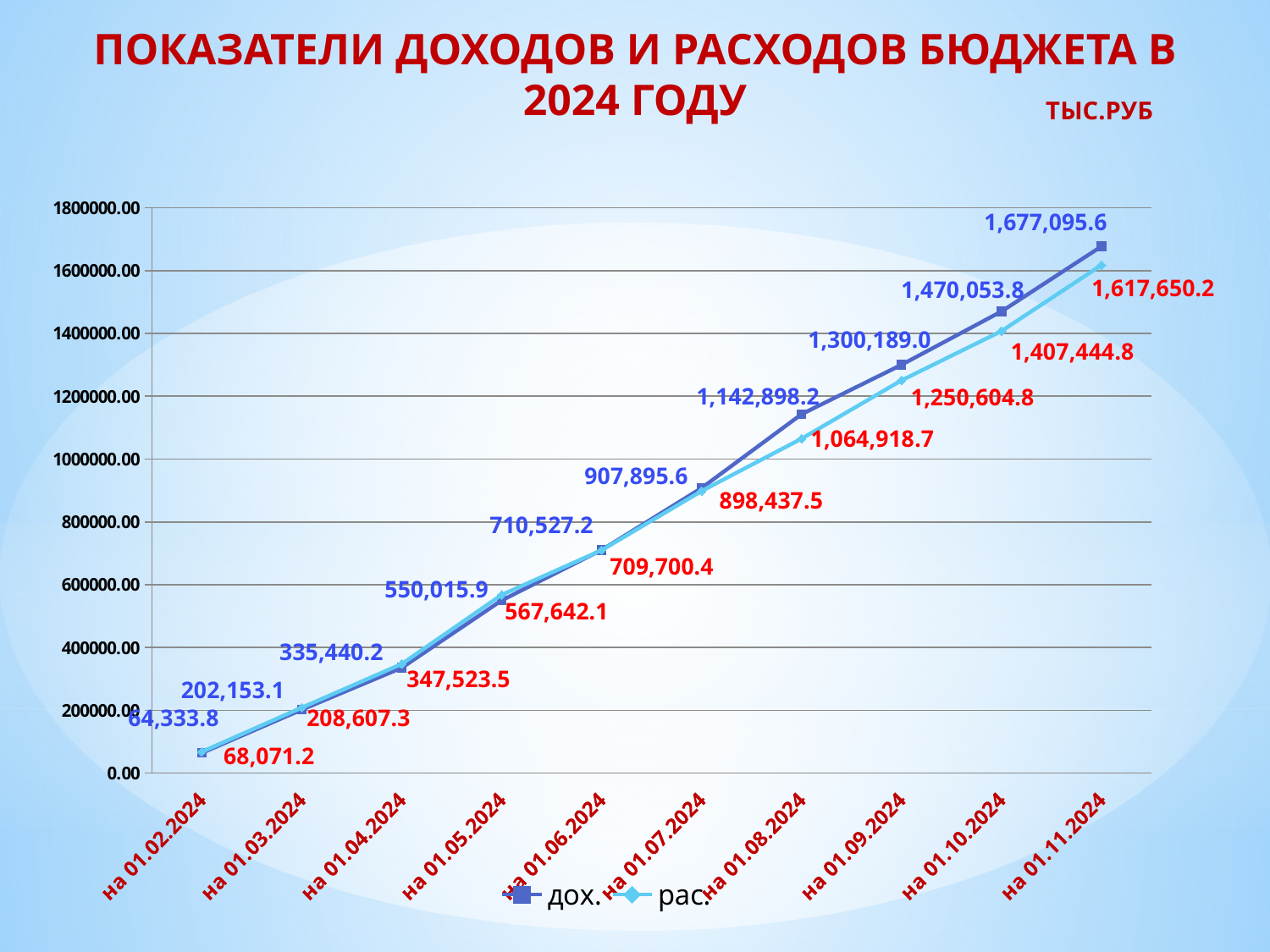
What is the difference between дох. and рас. on на 01.11.2024? 59,445.4 On which date is the рас. series at its lowest value? на 01.02.2024 How many series does the legend list? 2 What is the value of рас. on на 01.09.2024? 1,250,604.8 What kind of chart is shown on the slide? line chart What is the value of дох. on на 01.04.2024? 335,440.2 What is the value of дох. on на 01.07.2024? 907,895.6 How many dates are plotted on the x axis? 10 Which series has the larger value on на 01.10.2024, дох. or рас.? дох. Do the values of the дох. series rise or fall from на 01.02.2024 to на 01.11.2024? rise What is the value of рас. on на 01.02.2024? 68,071.2 On which date does the дох. series reach its highest value? на 01.11.2024